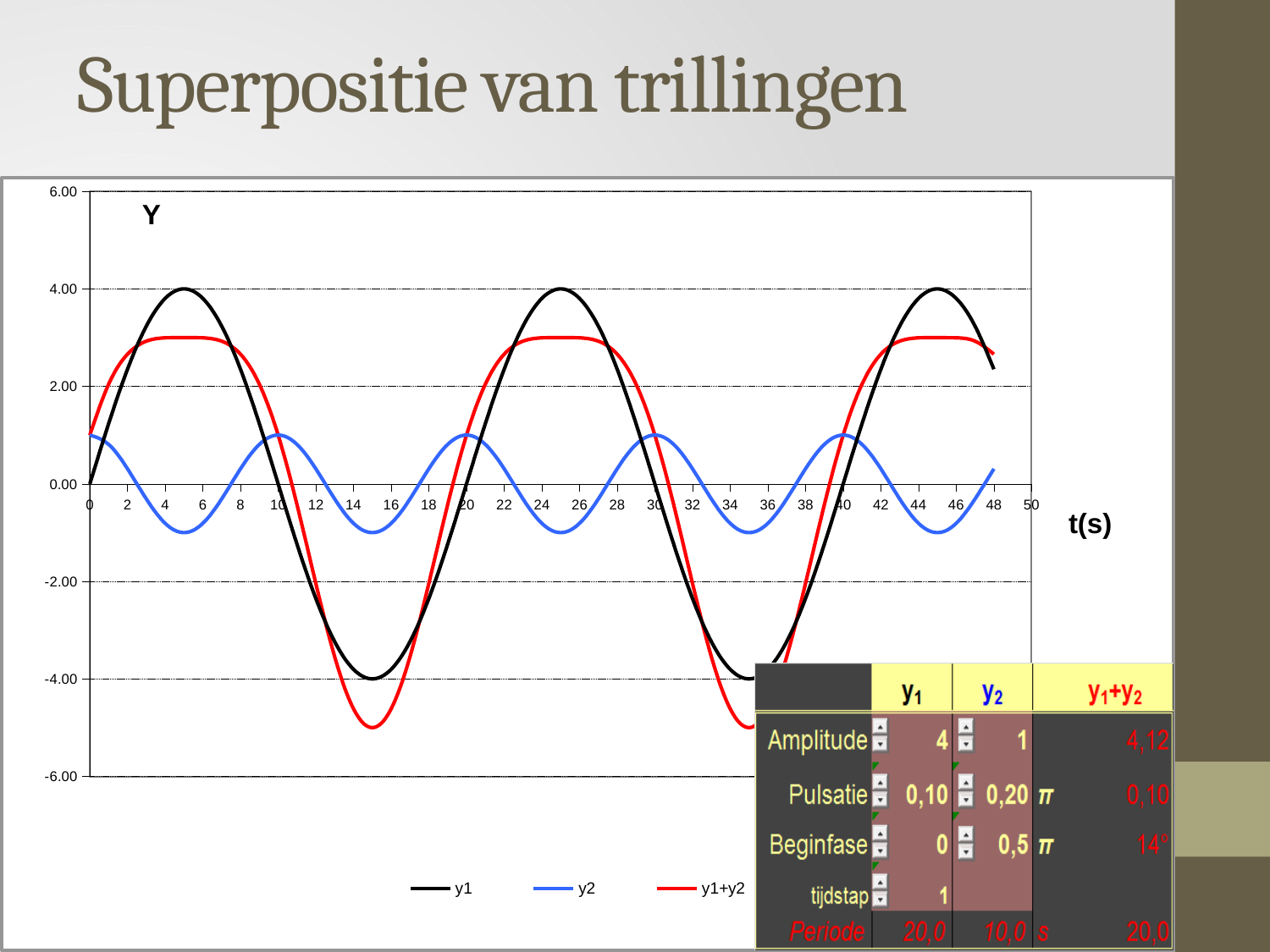
Is the value of y1+y2 at t = 15 greater or less than -4.00? less What is the label of the horizontal axis of the chart? t(s) Does y1 rise or fall between t = 5 and t = 15? fall Which series reaches the lowest value in the chart? y1+y2 What kind of chart is shown on the slide? line chart Which series is drawn in red in the chart? y1+y2 Is the value of y2 at t = 5 greater or less than 2.00? less What is the value of y1 at its peak at t = 5? 4.00 What is the value of y1 at its lowest point at t = 15? -4.00 Which series reaches the smallest peak value in the chart? y2 Is the value of y1+y2 at t = 5 greater or less than 2.00? greater How many series does the chart legend list? 3